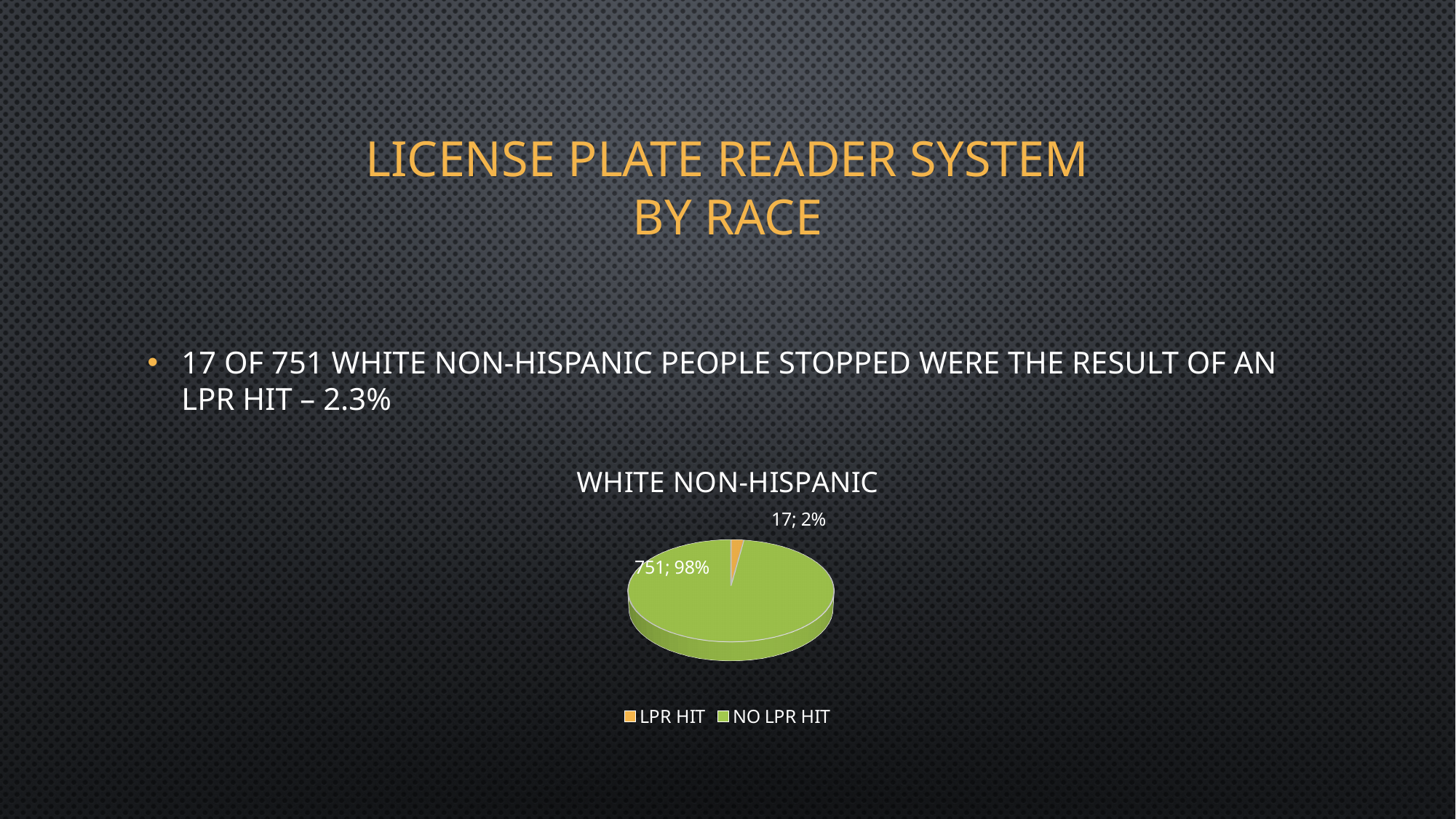
What is the difference between the NO LPR HIT value and the LPR HIT value? 734 Which slice is the largest? NO LPR HIT Which slice is the smallest? LPR HIT How many slices does the pie chart have? 2 What is the value shown for the NO LPR HIT slice? 751 Which colour represents the LPR HIT slice? orange What percentage share of the pie is the NO LPR HIT slice? 98% How many entries does the legend list? 2 What percentage share of the pie is the LPR HIT slice? 2% What is the value shown for the LPR HIT slice? 17 What is the title of the chart? WHITE NON-HISPANIC What type of chart is shown on the slide? pie chart